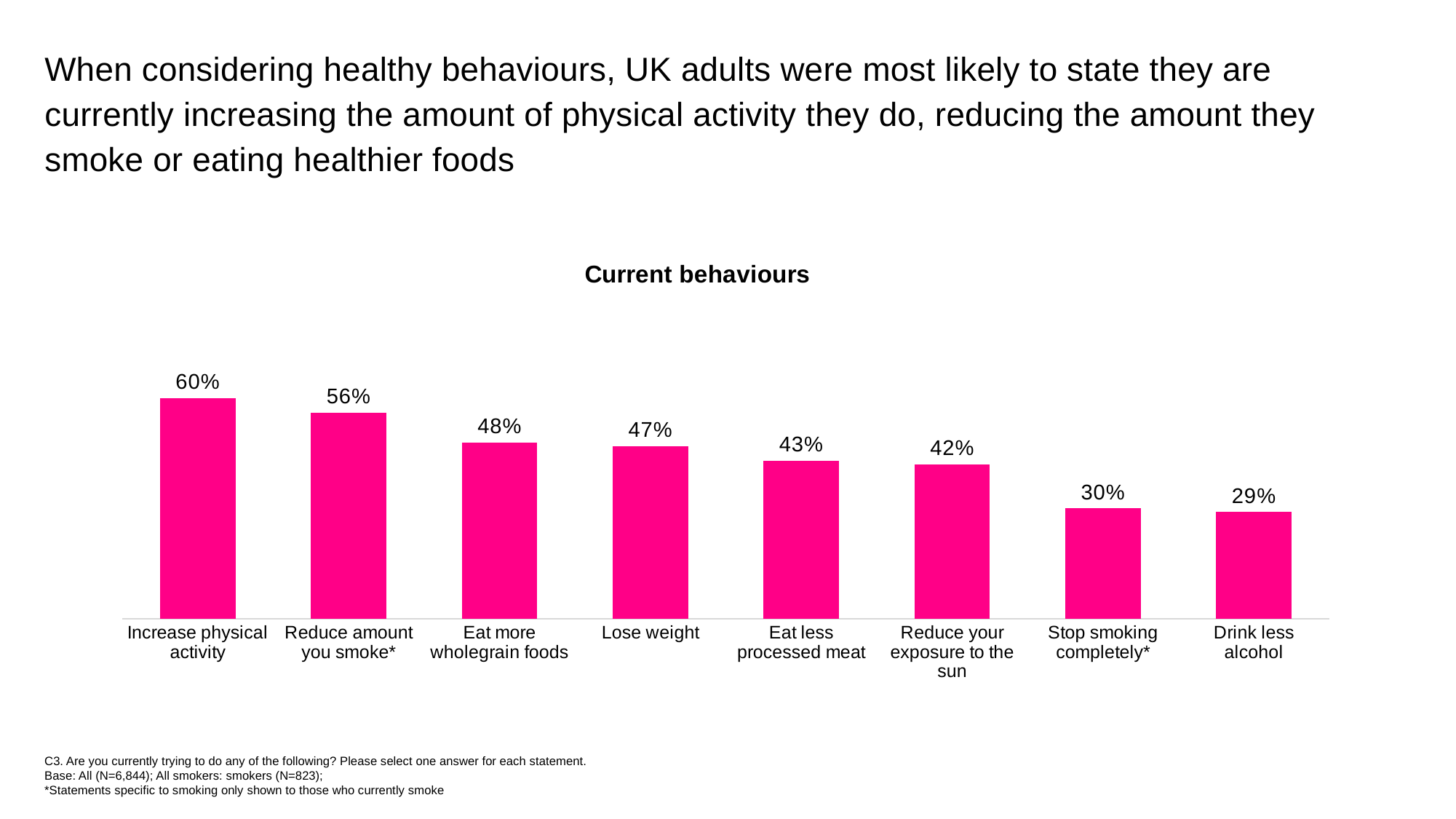
Which behaviour has the highest percentage in the chart? Increase physical activity What percentage of UK adults say they are currently trying to increase physical activity? 60% What is the difference between the values for 'Eat more wholegrain foods' and 'Stop smoking completely*'? 18 percentage points Which is larger: the value for 'Lose weight' or the value for 'Reduce your exposure to the sun'? Lose weight What type of chart is used on this slide? Bar chart How many behaviours are shown in the chart? 8 What is the difference between the values for 'Increase physical activity' and 'Reduce amount you smoke*'? 4 percentage points What is the value shown for 'Eat less processed meat'? 43% What is the value shown for 'Drink less alcohol'? 29% Which behaviour has the lowest percentage in the chart? Drink less alcohol Do the values rise or fall moving from left to right across the chart? Fall What is the title of the chart? Current behaviours